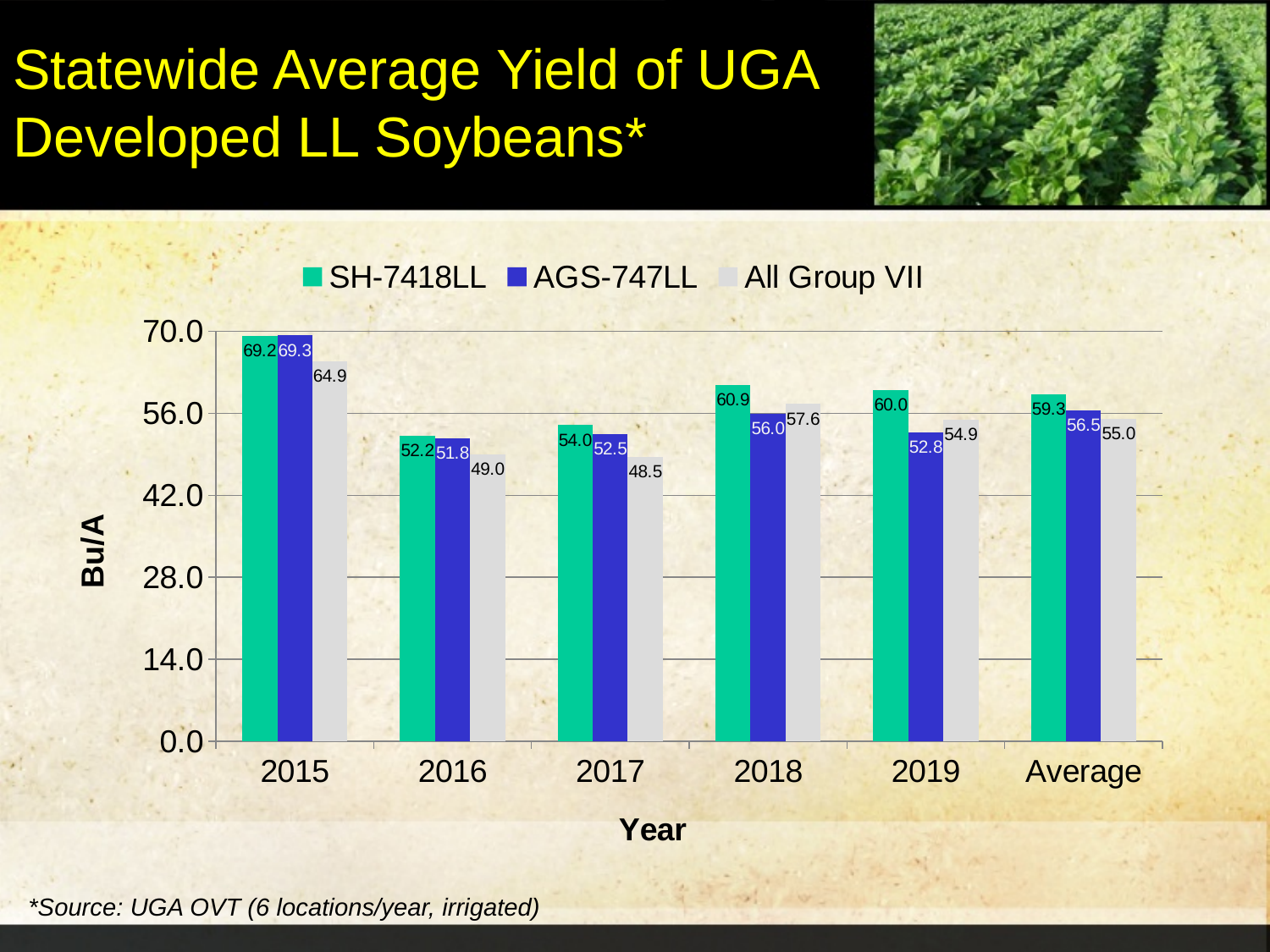
In which year is the All Group VII yield lowest? 2017 What is the yield for SH-7418LL in 2018? 60.9 How many series does the legend list? 3 Which has the higher yield in 2018, AGS-747LL or All Group VII? All Group VII What is the yield for All Group VII in 2016? 49.0 What kind of chart is shown on the slide? Bar chart What is the difference between the SH-7418LL and AGS-747LL yields in 2019? 7.2 Which series is shown in green? SH-7418LL In which year is the SH-7418LL yield highest? 2015 What is the Average yield for AGS-747LL? 56.5 What is the label of the y axis? Bu/A How many categories are shown on the x axis? 6